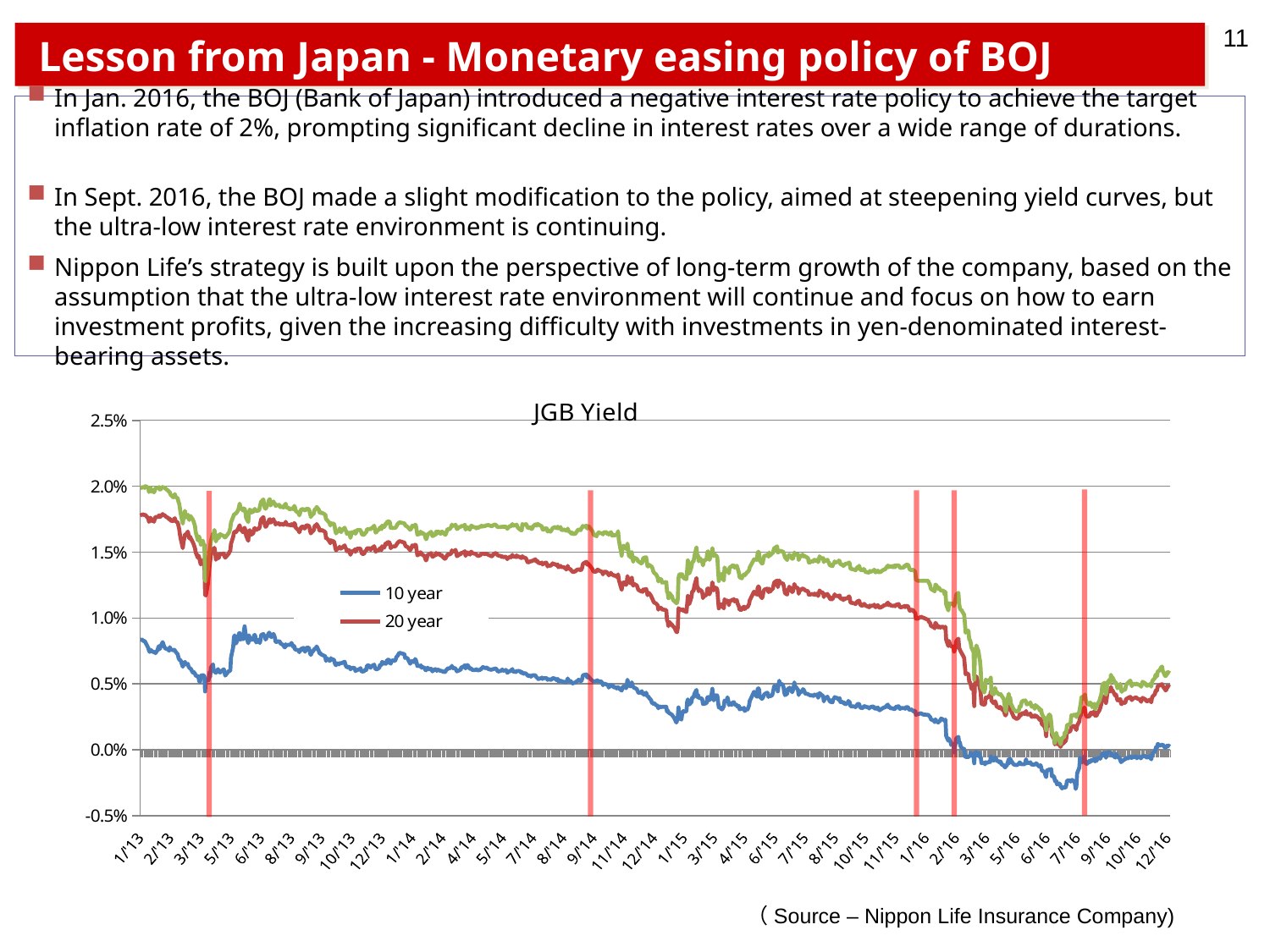
Does the 10 year yield generally rise or fall from 1/'13 to 12/'16? fall How many vertical red marker lines are drawn on the chart? 5 What kind of chart is shown on the slide? line chart What is the title of the chart? JGB Yield What colour is the 10 year line in the chart? blue Is the 10 year yield at 1/'13 greater or less than 0.5%? greater Is the 10 year yield around 6/'16 greater or less than 0.0%? less At 1/'13, which is higher, the 10 year yield or the 20 year yield? 20 year How many series does the chart's legend list? 2 Does the 20 year yield generally rise or fall from 1/'13 to 12/'16? fall Is the 20 year yield at 1/'13 greater or less than 1.5%? greater